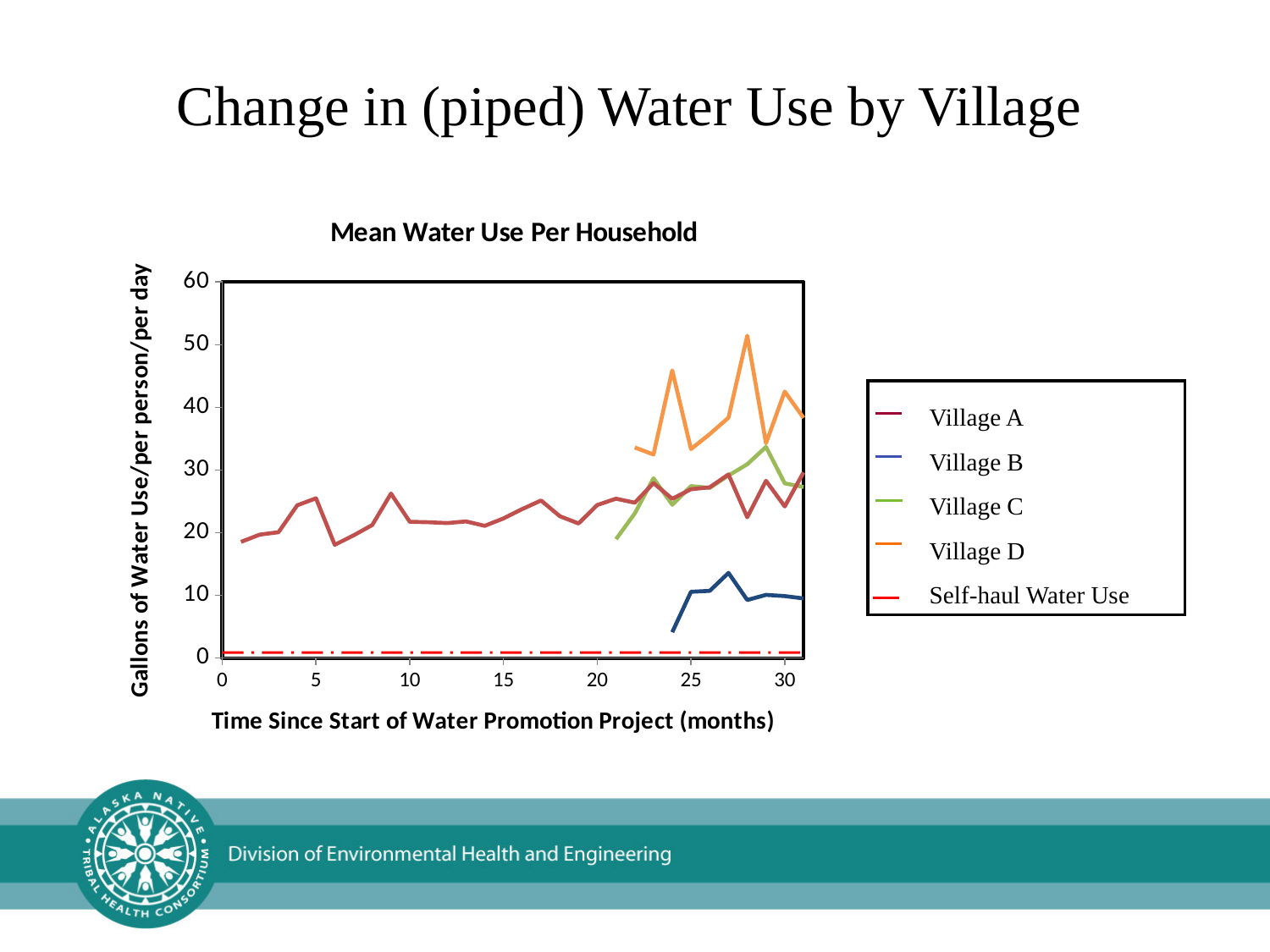
Is the value for Village D at month 28 greater or less than 40? greater Which series has the highest water use at month 28? Village D Is the value for Village A at month 5 greater or less than 20? greater At month 25, which is larger: Village D or Village A? Village D What kind of chart is shown on the slide? line chart What is the label of the x axis? Time Since Start of Water Promotion Project (months) Which village's line starts earliest on the x axis? Village A Does Village B rise or fall from month 24 to month 27? rise What is the title of the chart? Mean Water Use Per Household Which series has the lowest values across the whole chart? Self-haul Water Use Is the value for Village B at month 24 greater or less than 10? less How many series does the legend list? 5